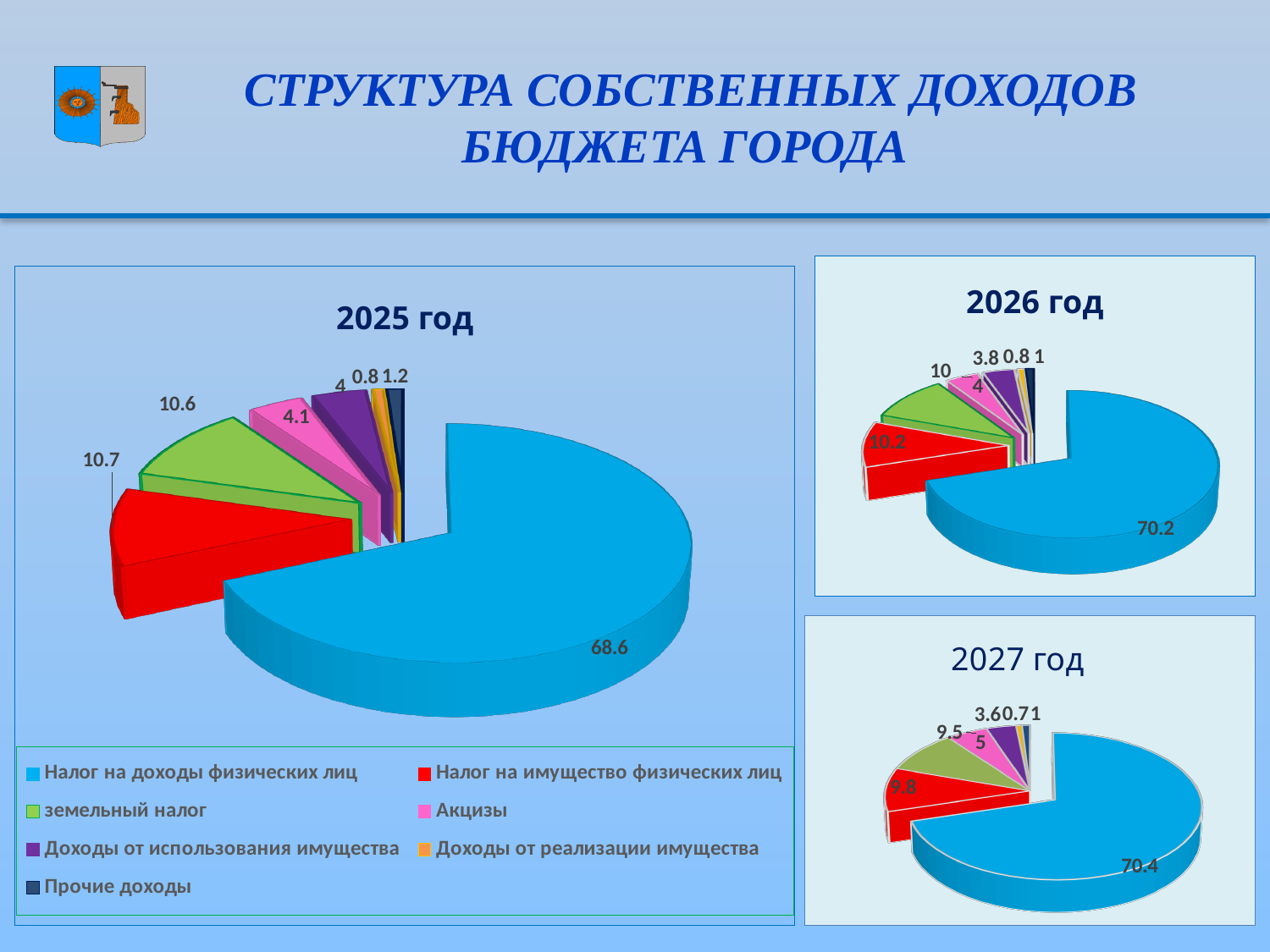
In the 2026 год chart, what is the value for Налог на имущество физических лиц? 10.2 In the 2025 год chart, what is the value for Налог на доходы физических лиц? 68.6 In the 2025 год chart, what is the difference between the values for Налог на доходы физических лиц and Налог на имущество физических лиц? 57.9 In the 2025 год chart, which category has the smallest slice? Доходы от реализации имущества In the 2025 год chart, what is the value for земельный налог? 10.6 How many entries does the legend list? 7 In the 2027 год chart, what is the difference between the values for Налог на имущество физических лиц and земельный налог? 0.3 In the 2025 год chart, which is larger: земельный налог or Акцизы? земельный налог What type of chart is used for 2025 год? Pie chart In the 2027 год chart, what is the value for Акцизы? 5 How many slices does the 2026 год chart have? 7 In the 2027 год chart, which category has the largest slice? Налог на доходы физических лиц